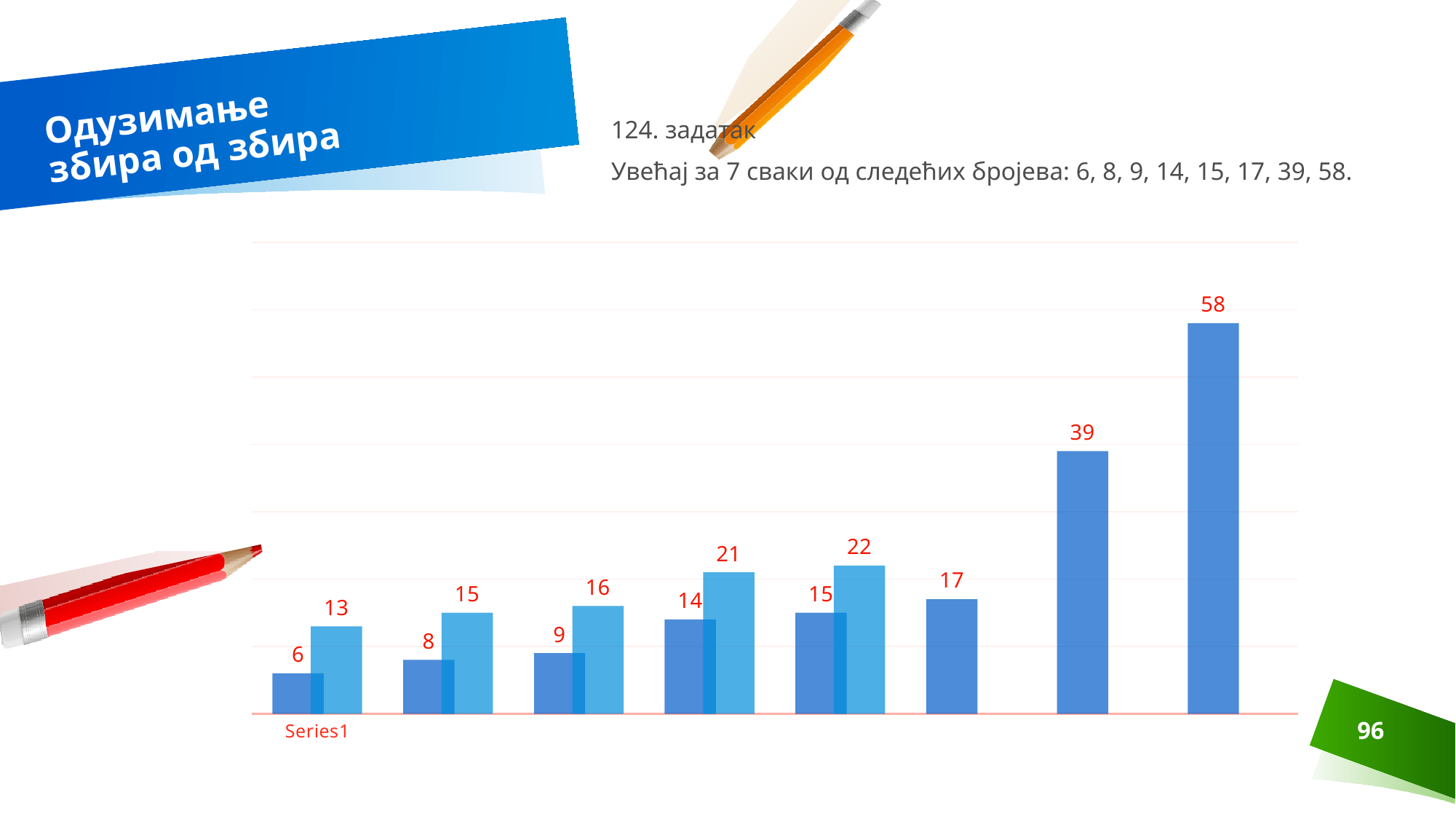
What is the value of the shortest dark blue bar? 6 What is the difference between the light blue bar labelled 13 and the dark blue bar labelled 6 beside it? 7 What is the value of the tallest dark blue bar? 58 Which is larger: the light blue bar labelled 22 or the dark blue bar labelled 17? the light blue bar labelled 22 What is the difference between the tallest dark blue bar (58) and the shortest dark blue bar (6)? 52 What is the value of the light blue bar that stands next to the dark blue bar labelled 6? 13 Do the values of the dark blue bars rise or fall from left to right? rise What label is printed on the horizontal axis under the first bar? Series1 What is the value of the light blue bar that stands next to the dark blue bar labelled 14? 21 How many dark blue bars are plotted in the chart? 8 How many light blue bars are plotted in the chart? 5 What kind of chart is shown on the slide? bar chart